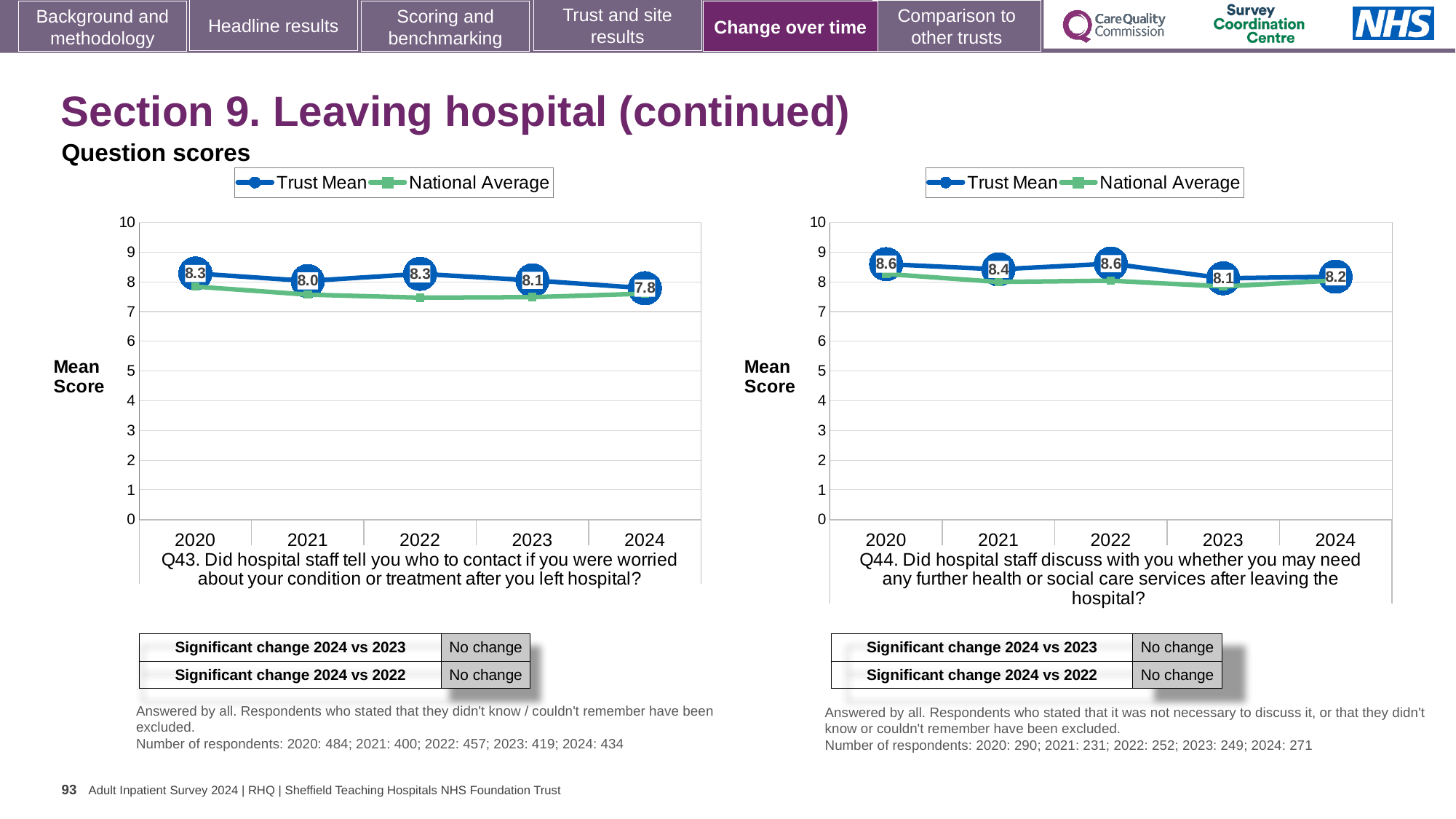
How many years are shown on the x axis of the left chart (Q43)? 5 In the right chart (Q44), which year has the higher Trust Mean score, 2021 or 2024? 2021 In the right chart (Q44), is the National Average value for 2020 greater or less than 8? greater How many series does the legend of the right chart (Q44) list? 2 In the left chart (Q43), which year has the lowest Trust Mean score? 2024 In the left chart (Q43), what is the Trust Mean score for 2024? 7.8 What kind of chart is the left chart (Q43)? Line chart In the right chart (Q44), what is the difference between the Trust Mean scores for 2020 and 2023? 0.5 In the left chart (Q43), what is the difference between the Trust Mean scores for 2020 and 2024? 0.5 In the left chart (Q43), is the National Average value for 2022 greater or less than 8? less In the right chart (Q44), which year has the lowest Trust Mean score? 2023 In the right chart (Q44), what is the Trust Mean score for 2021? 8.4